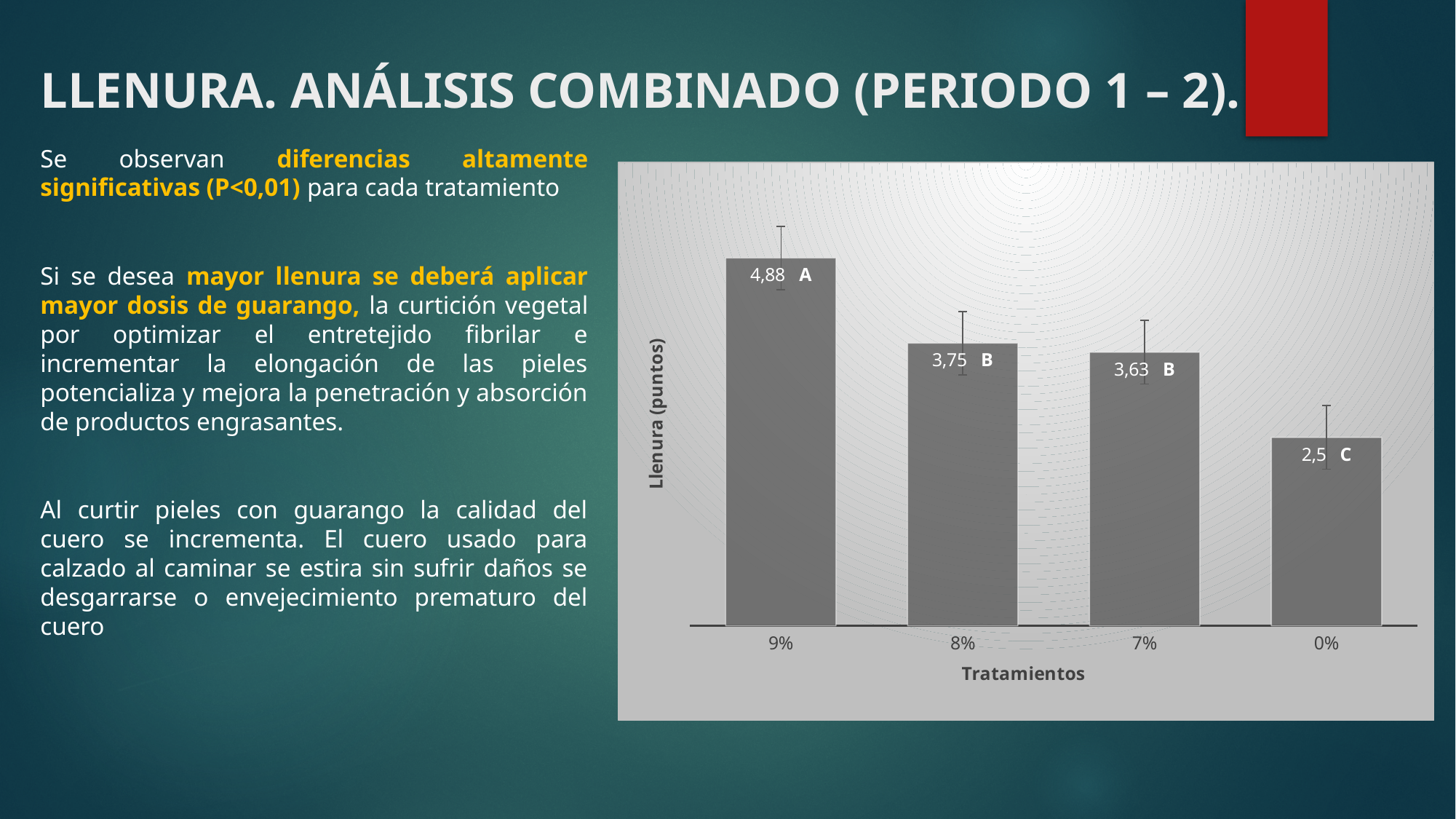
Which treatment has the lowest llenura value? 0% What is the difference between the llenura values for the 9% and 8% treatments? 1,13 Which treatment has the highest llenura value? 9% What is the label of the y axis of the chart? Llenura (puntos) What is the difference between the llenura values for the 9% and 0% treatments? 2,38 Which treatment has a larger llenura value, 8% or 0%? 8% What kind of chart is shown on the slide? Bar chart What is the llenura value for the 0% treatment? 2,5 What is the llenura value for the 7% treatment? 3,63 How many treatments are shown on the x axis of the chart? 4 What is the llenura value for the 9% treatment? 4,88 What is the llenura value for the 8% treatment? 3,75